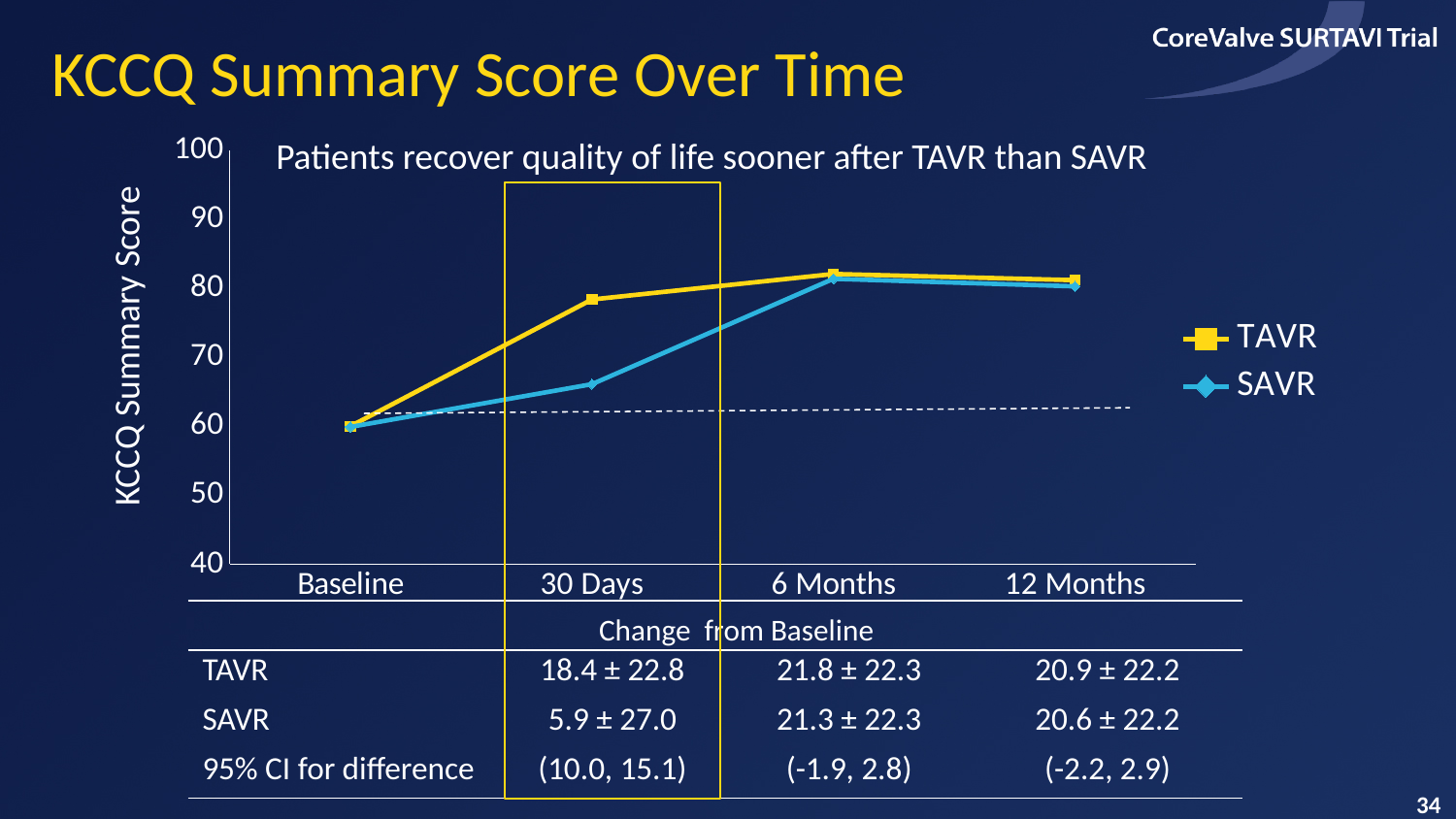
Is the SAVR value at 6 Months greater or less than 70? greater Is the TAVR value at 30 Days greater or less than 70? greater Does the SAVR score rise or fall from Baseline to 6 Months? rise How many series does the legend list? 2 At 30 Days, which series has the higher KCCQ Summary Score, TAVR or SAVR? TAVR What kind of chart is shown on the slide? line chart Is the TAVR value at Baseline greater or less than 70? less At which time point is the TAVR score lowest? Baseline Which series is plotted in yellow? TAVR What is the y-axis label of the chart? KCCQ Summary Score How many time points are shown on the x axis? 4